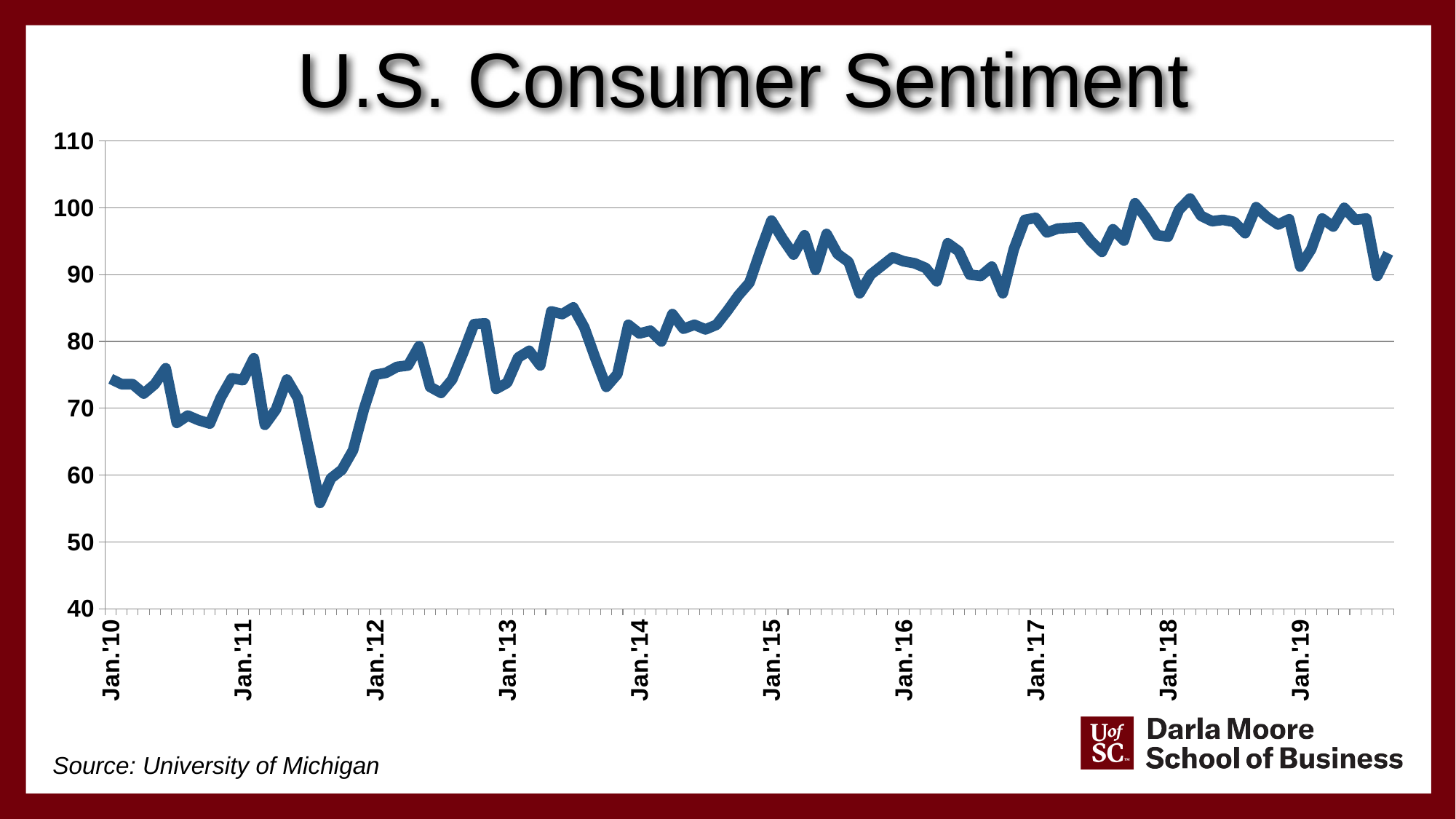
What source is cited for the chart's data? University of Michigan Which is larger, the value at Jan '10 or the value at Jan '15? Jan '15 In which year does the line reach its lowest point? 2011 What kind of chart is shown on the slide? line chart Which is larger, the value at Jan '17 or the value at Jan '19? Jan '17 What is the title of the chart? U.S. Consumer Sentiment How many data series are plotted on the chart? 1 Is the value at Jan '15 greater or less than 90? greater Is the lowest value on the line greater or less than 60? less Is the value at Jan '13 greater or less than 80? less Overall, does consumer sentiment rise or fall from Jan '10 to the end of the series in 2019? rise